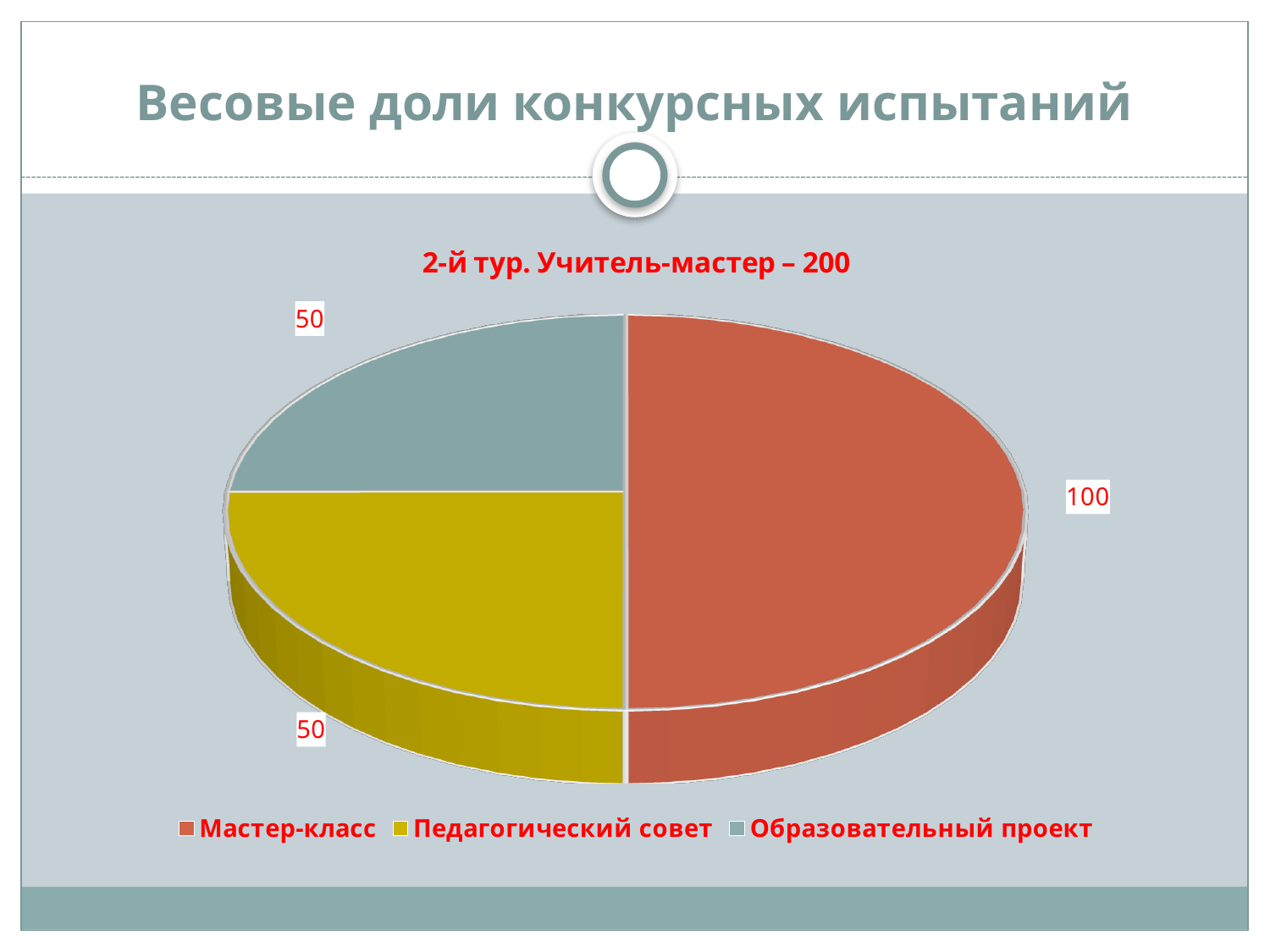
What is the difference between the values for Мастер-класс and Педагогический совет? 50 What is the value for Педагогический совет? 50 What is the value for Мастер-класс? 100 What share of the pie does Мастер-класс represent? 50% How many slices does the pie chart have? 3 What is the value for Образовательный проект? 50 Which is larger, the value for Мастер-класс or the value for Образовательный проект? Мастер-класс How many entries does the legend list? 3 What is the title of the chart? 2-й тур. Учитель-мастер – 200 Which category has the largest slice of the pie? Мастер-класс What type of chart is shown on the slide? Pie chart What share of the pie does Педагогический совет represent? 25%